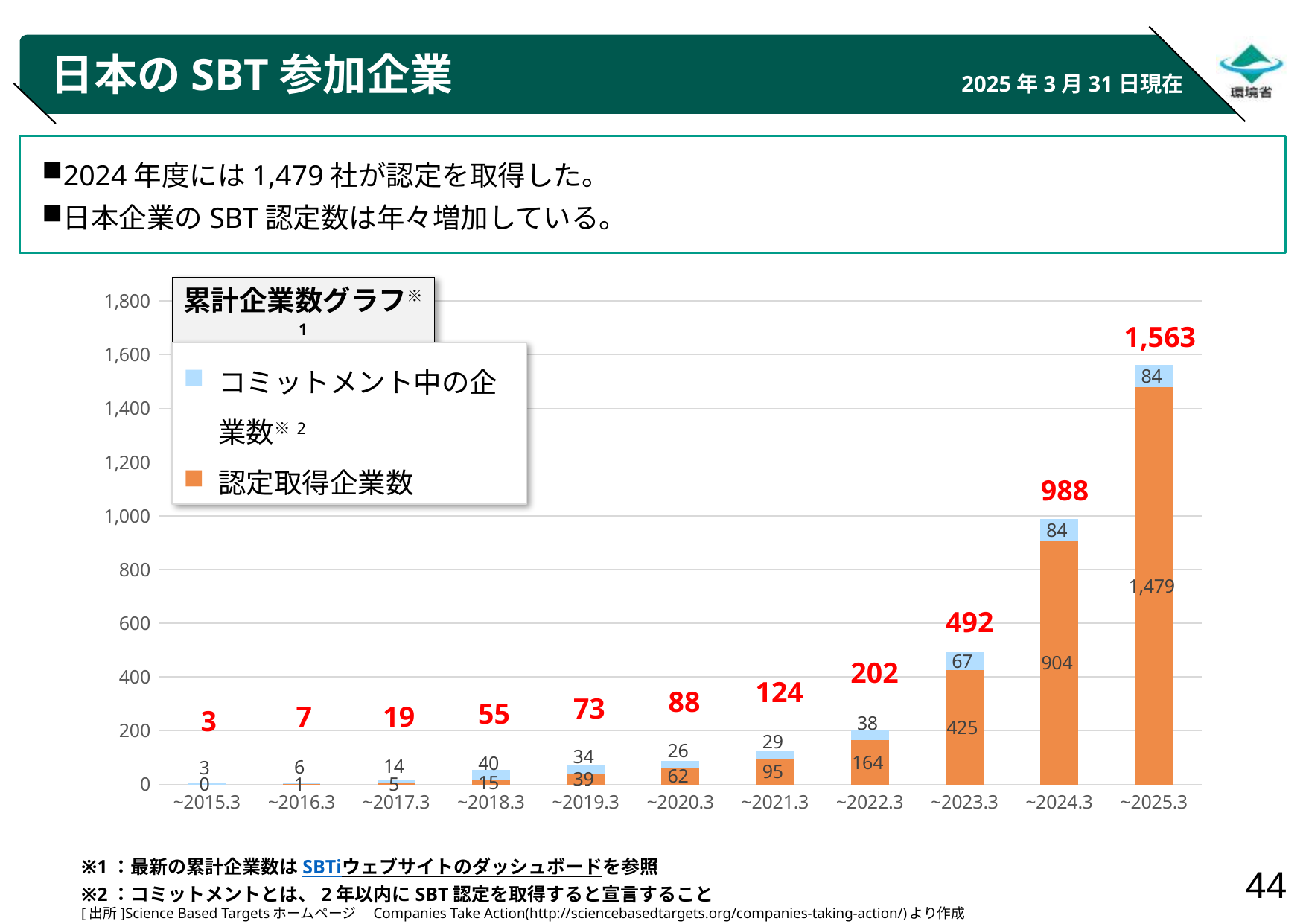
What is the value of 認定取得企業数 for ~2025.3? 1,479 What type of chart is shown on the slide? stacked bar chart Which colour represents 認定取得企業数 in the chart? orange Which is larger for ~2019.3: コミットメント中の企業数 or 認定取得企業数? 認定取得企業数 How many time-period categories are shown on the x axis? 11 What is the difference between the 認定取得企業数 values for ~2025.3 and ~2024.3? 575 Do the total values rise or fall from ~2015.3 to ~2025.3? rise Which period has the lowest total number of companies? ~2015.3 What is the value of コミットメント中の企業数 for ~2023.3? 67 Which period has the highest total number of companies? ~2025.3 How many series does the chart legend list? 2 What is the total (red label) for ~2024.3? 988